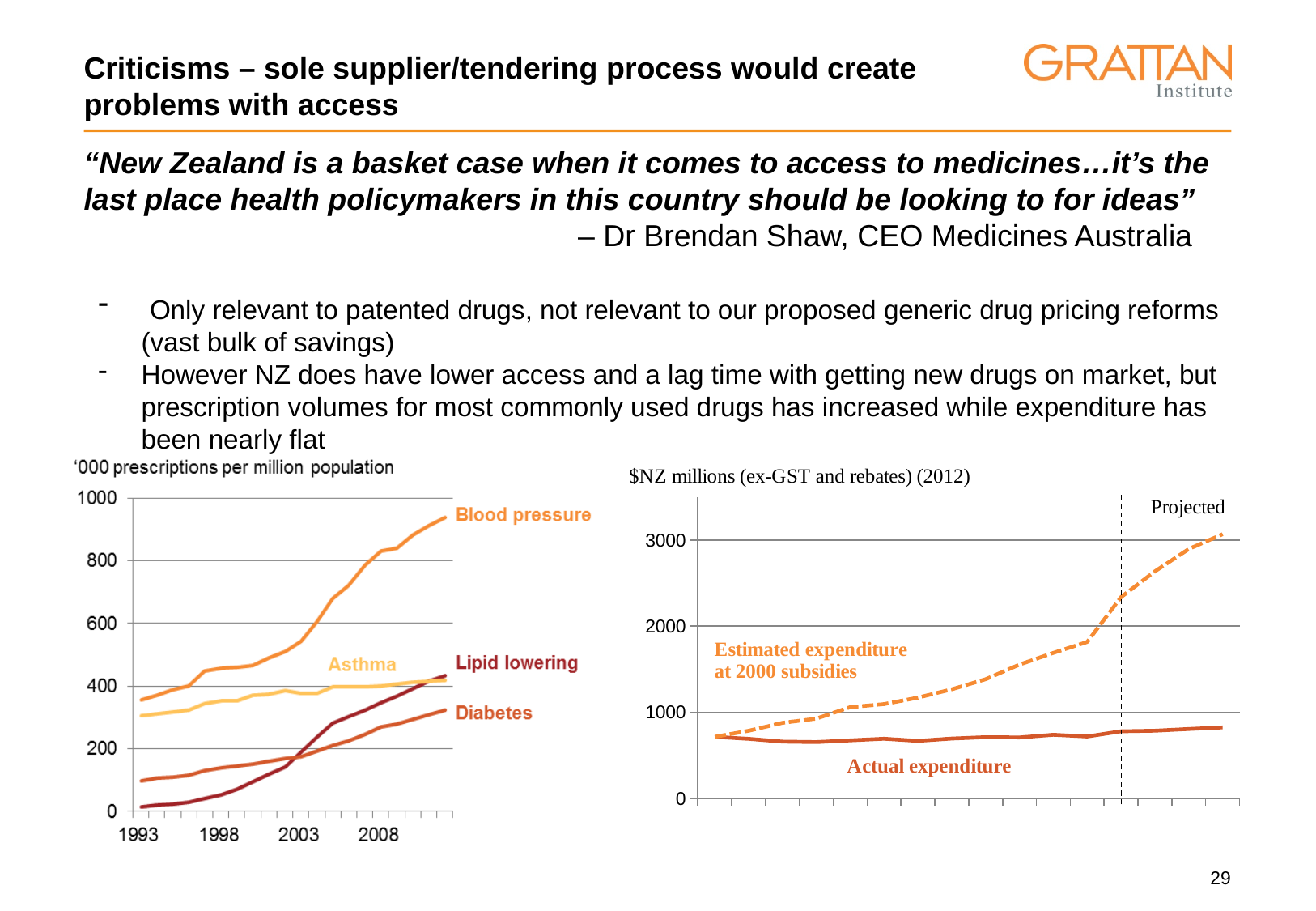
On the left chart ('000 prescriptions per million population), is the final value for Blood pressure greater or less than 800? greater On the left chart ('000 prescriptions per million population), which series has the highest value at the end of the period? Blood pressure On the left chart ('000 prescriptions per million population), is the value for Blood pressure in 1993 greater or less than 200? greater On the left chart ('000 prescriptions per million population), which series has the lowest value in 1993? Lipid lowering On the left chart ('000 prescriptions per million population), which is larger in 1993: Asthma or Diabetes? Asthma How many series are plotted on the right chart ($NZ millions expenditure)? 2 On the left chart ('000 prescriptions per million population), does the Blood pressure series rise or fall from 1993 onwards? rise On the right chart ($NZ millions), is the final value for Actual expenditure greater or less than 1000? less How many series are plotted on the left chart ('000 prescriptions per million population)? 4 What kind of chart is the left chart showing '000 prescriptions per million population? line chart